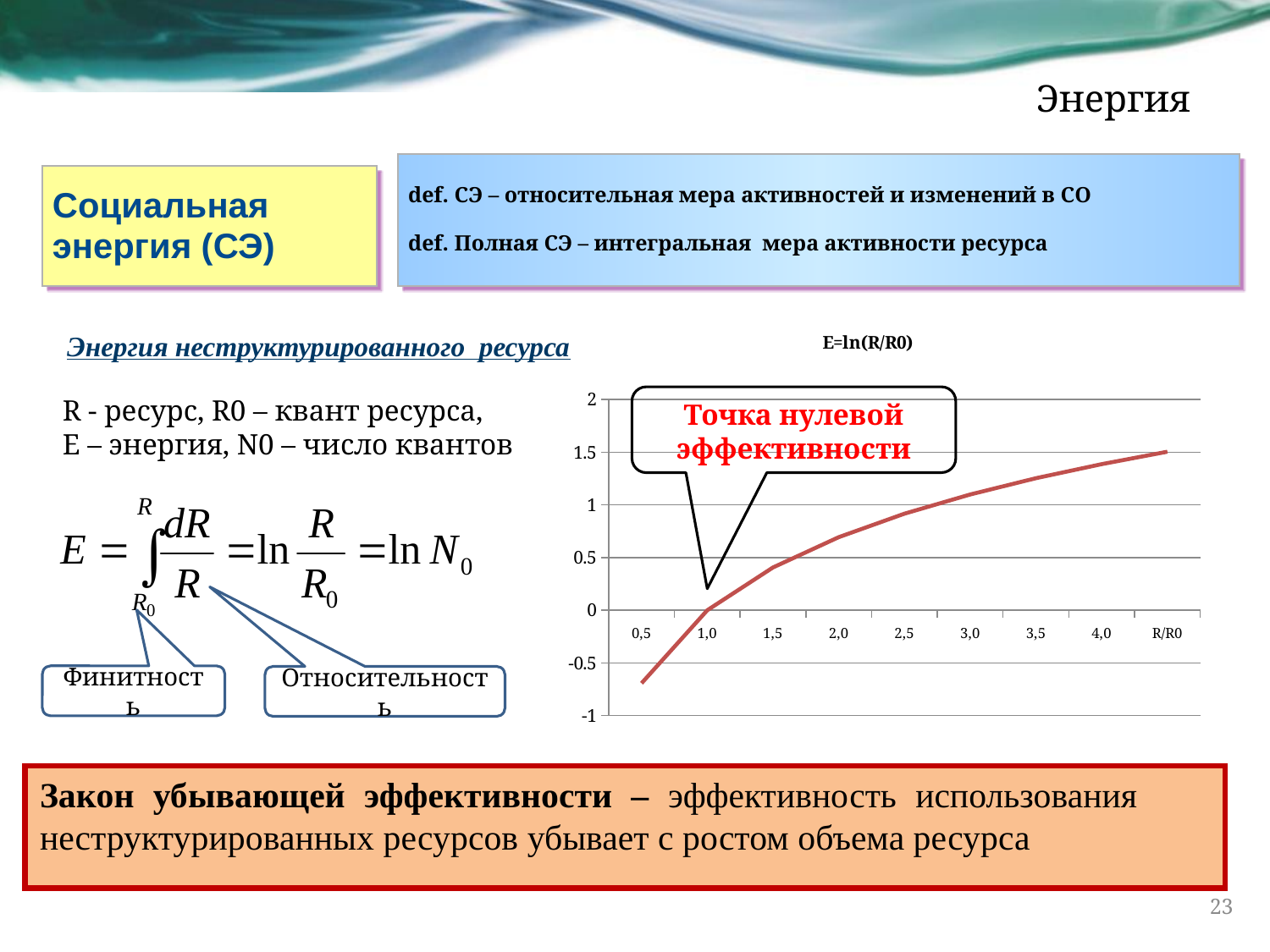
Do the values on the chart rise or fall as R/R0 increases? rise Is the value of E at R/R0 = 0,5 greater or less than -0.5? less What kind of chart is shown on the slide? line chart How many labelled R/R0 tick values are shown on the x axis? 8 Is the value of E at R/R0 = 3,5 greater or less than 1? greater What is the value of E at R/R0 = 1,0? 0 At which value of R/R0 is the curve at its lowest point on the chart? 0,5 What does the callout on the chart label the point where the curve crosses zero? Точка нулевой эффективности Which is larger, the value of E at R/R0 = 1,5 or at R/R0 = 3,0? 3,0 Is the value of E at R/R0 = 2,0 greater or less than 0.5? greater What is the title of the chart? E=ln(R/R0)